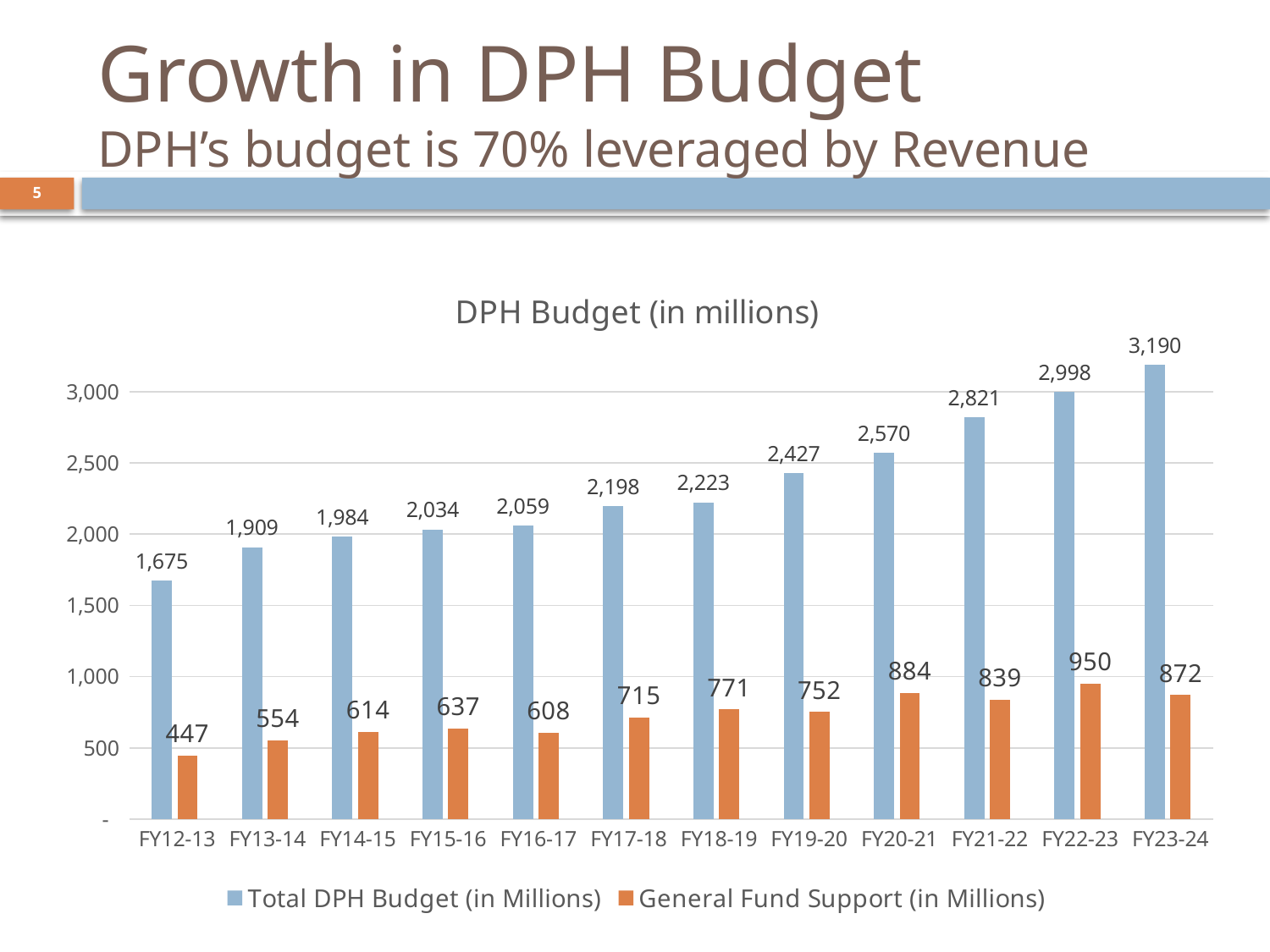
What is the Total DPH Budget (in Millions) for FY19-20? 2,427 What is the General Fund Support (in Millions) for FY22-23? 950 Does the Total DPH Budget rise or fall from FY12-13 to FY23-24? Rise Is the Total DPH Budget for FY20-21 greater or less than 2,500? greater How many series does the legend list? 2 What kind of chart is shown on the slide? Bar chart What is the Total DPH Budget (in Millions) for FY12-13? 1,675 How many fiscal years are shown on the x axis? 12 What is the difference between the Total DPH Budget for FY23-24 and FY22-23? 192 Which is larger, the General Fund Support for FY20-21 or for FY21-22? FY20-21 Which fiscal year has the highest Total DPH Budget? FY23-24 Which fiscal year has the lowest General Fund Support? FY12-13